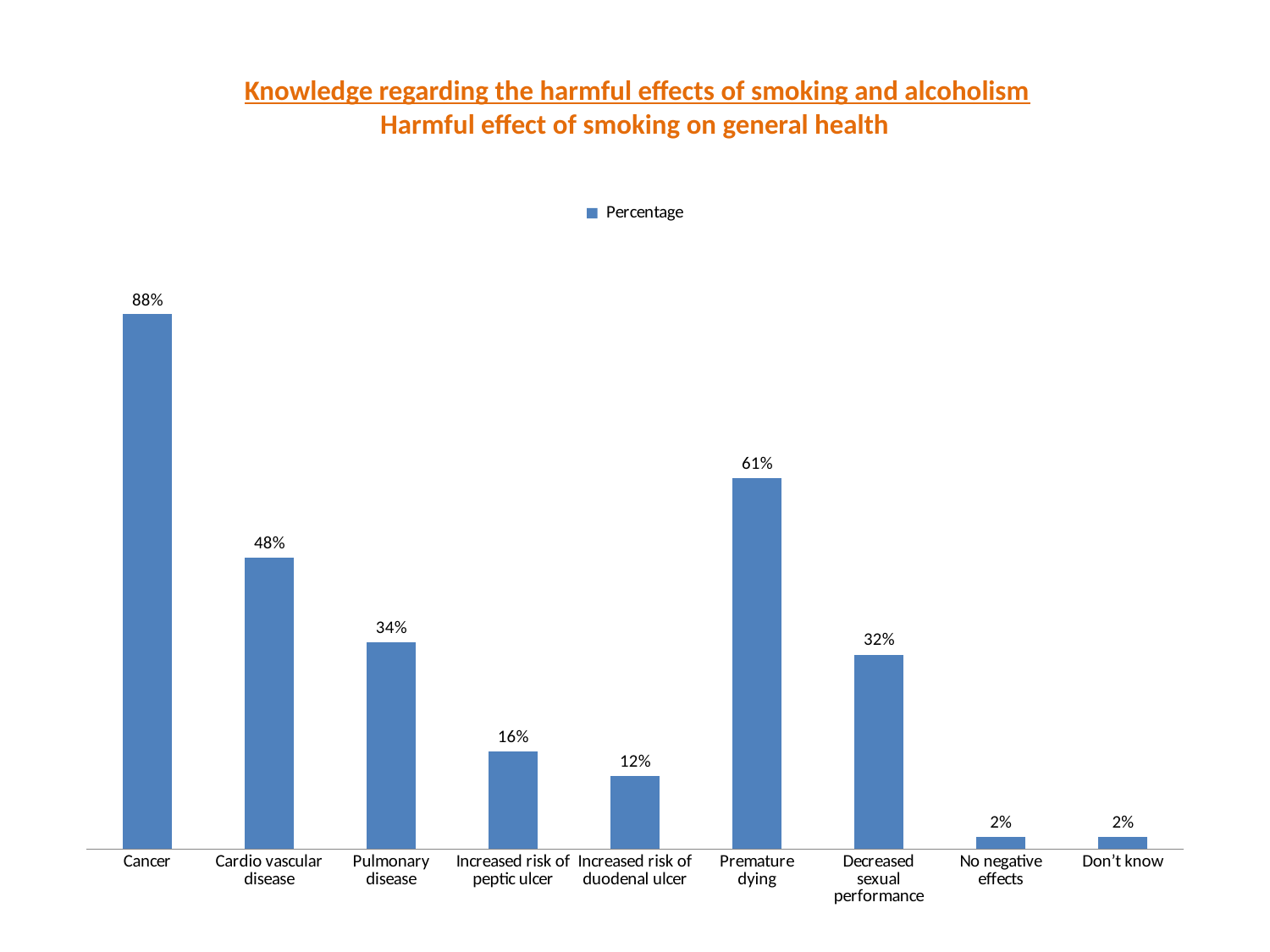
What kind of chart is shown on the slide? Bar chart What is the difference between the values for Cancer and Premature dying? 27% Which is larger, the value for Increased risk of peptic ulcer or the value for Increased risk of duodenal ulcer? Increased risk of peptic ulcer Which is larger, the value for Decreased sexual performance or the value for Pulmonary disease? Pulmonary disease What is the difference between the values for Cardio vascular disease and Pulmonary disease? 14% How many categories are shown on the x axis? 9 How many series does the legend list? 1 Which category has the highest value? Cancer What is the value for Increased risk of duodenal ulcer? 12% What is the name of the series shown in the legend? Percentage What is the value for Cancer? 88% What is the value for Premature dying? 61%